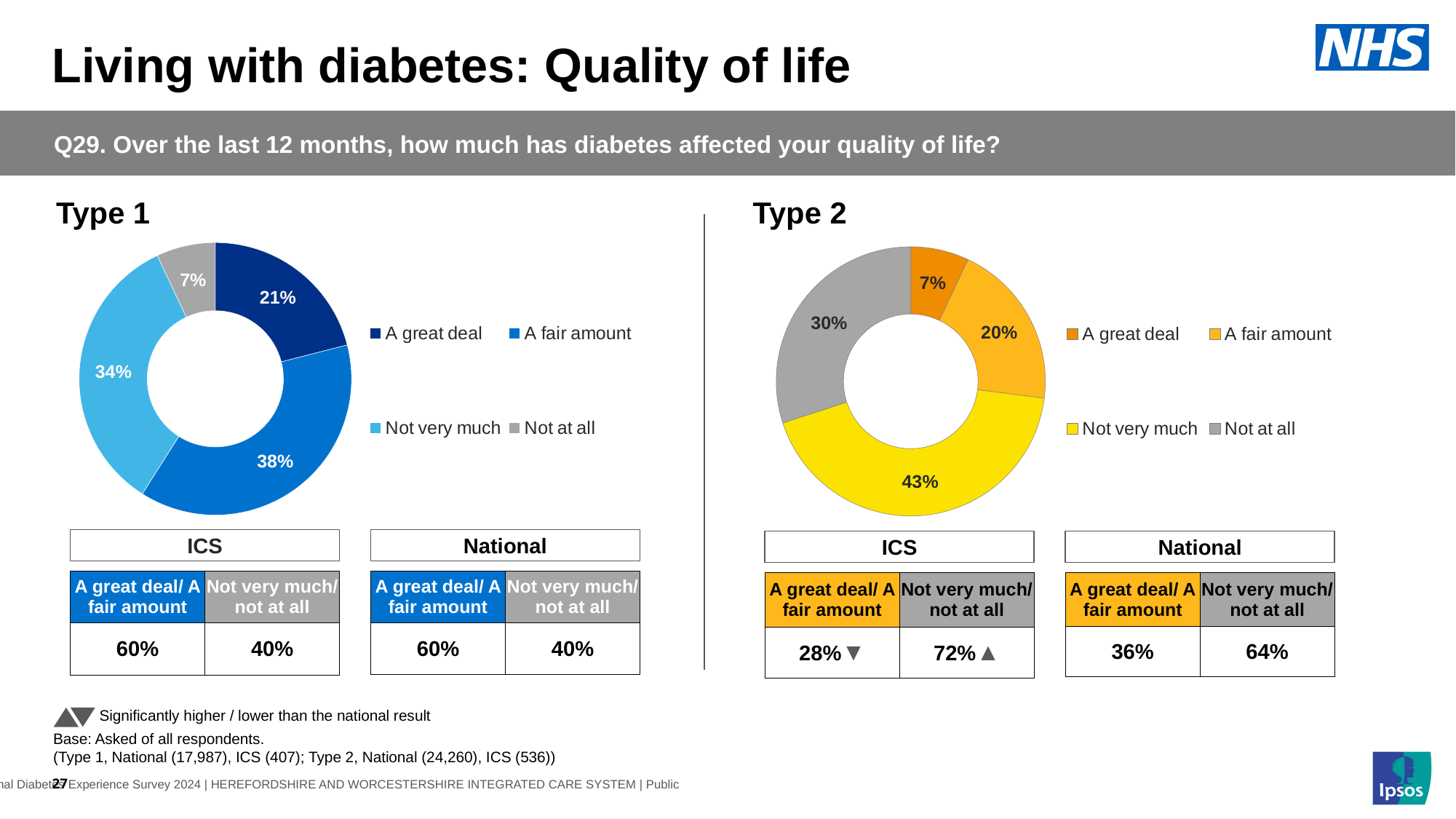
How many entries does the legend of the Type 2 chart list? 4 What kind of chart is used for the Type 2 data? Doughnut (pie) chart In the Type 1 chart, what percentage of respondents said diabetes affected their quality of life 'A fair amount'? 38% In the Type 2 chart, what percentage of respondents said 'Not at all'? 30% In the Type 1 chart, which is larger: the share for 'Not very much' or the share for 'A great deal'? Not very much In the Type 2 chart, what is the difference in percentage points between 'Not very much' and 'Not at all'? 13 In the Type 1 chart, which response category has the largest share? A fair amount In the Type 2 chart, which response category has the smallest share? A great deal In the Type 1 chart, what colour is the 'Not at all' segment? Grey In the Type 2 chart, what percentage of respondents said 'Not very much'? 43% In the Type 1 chart, what is the combined share of 'A great deal' and 'A fair amount'? 59% How many response categories are shown in the Type 1 chart? 4